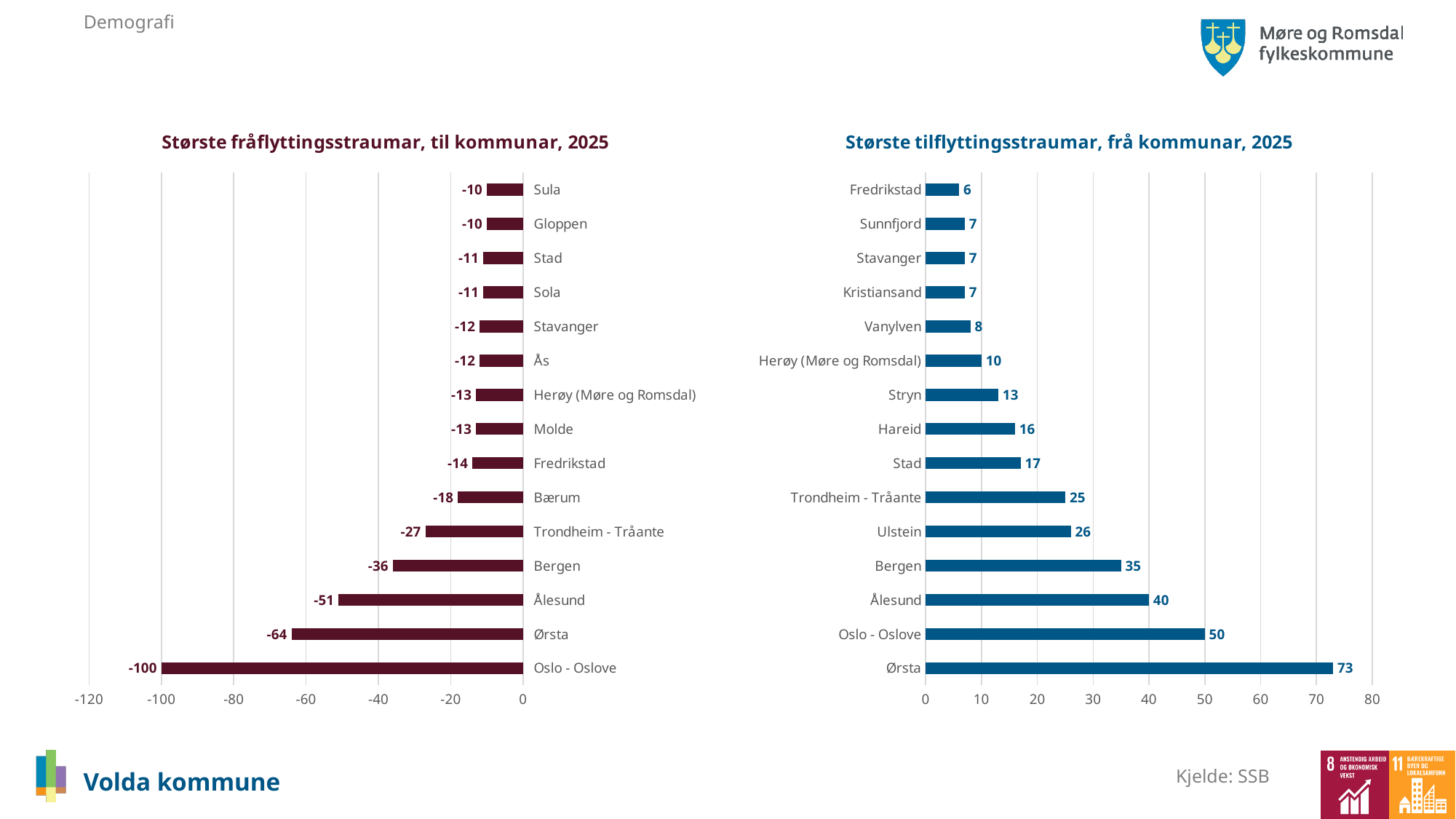
In the chart 'Største tilflyttingsstraumar, frå kommunar, 2025', what is the difference between the values for Ørsta and Oslo - Oslove? 23 What type of chart is 'Største tilflyttingsstraumar, frå kommunar, 2025'? Bar chart In the chart 'Største fråflyttingsstraumar, til kommunar, 2025', what is the value for Ålesund? -51 In the chart 'Største tilflyttingsstraumar, frå kommunar, 2025', which category has the lowest value? Fredrikstad In the chart 'Største tilflyttingsstraumar, frå kommunar, 2025', which is larger, the value for Bergen or the value for Trondheim - Tråante? Bergen In the chart 'Største tilflyttingsstraumar, frå kommunar, 2025', which category has the highest value? Ørsta In the chart 'Største fråflyttingsstraumar, til kommunar, 2025', which category has the lowest (most negative) value? Oslo - Oslove In the chart 'Største fråflyttingsstraumar, til kommunar, 2025', what is the difference between the values for Ørsta and Bergen? 28 How many categories are shown in the chart 'Største fråflyttingsstraumar, til kommunar, 2025'? 15 In the chart 'Største tilflyttingsstraumar, frå kommunar, 2025', what is the value for Ulstein? 26 How many categories are shown in the chart 'Største tilflyttingsstraumar, frå kommunar, 2025'? 15 What is the source cited at the bottom of the slide for the charts? SSB